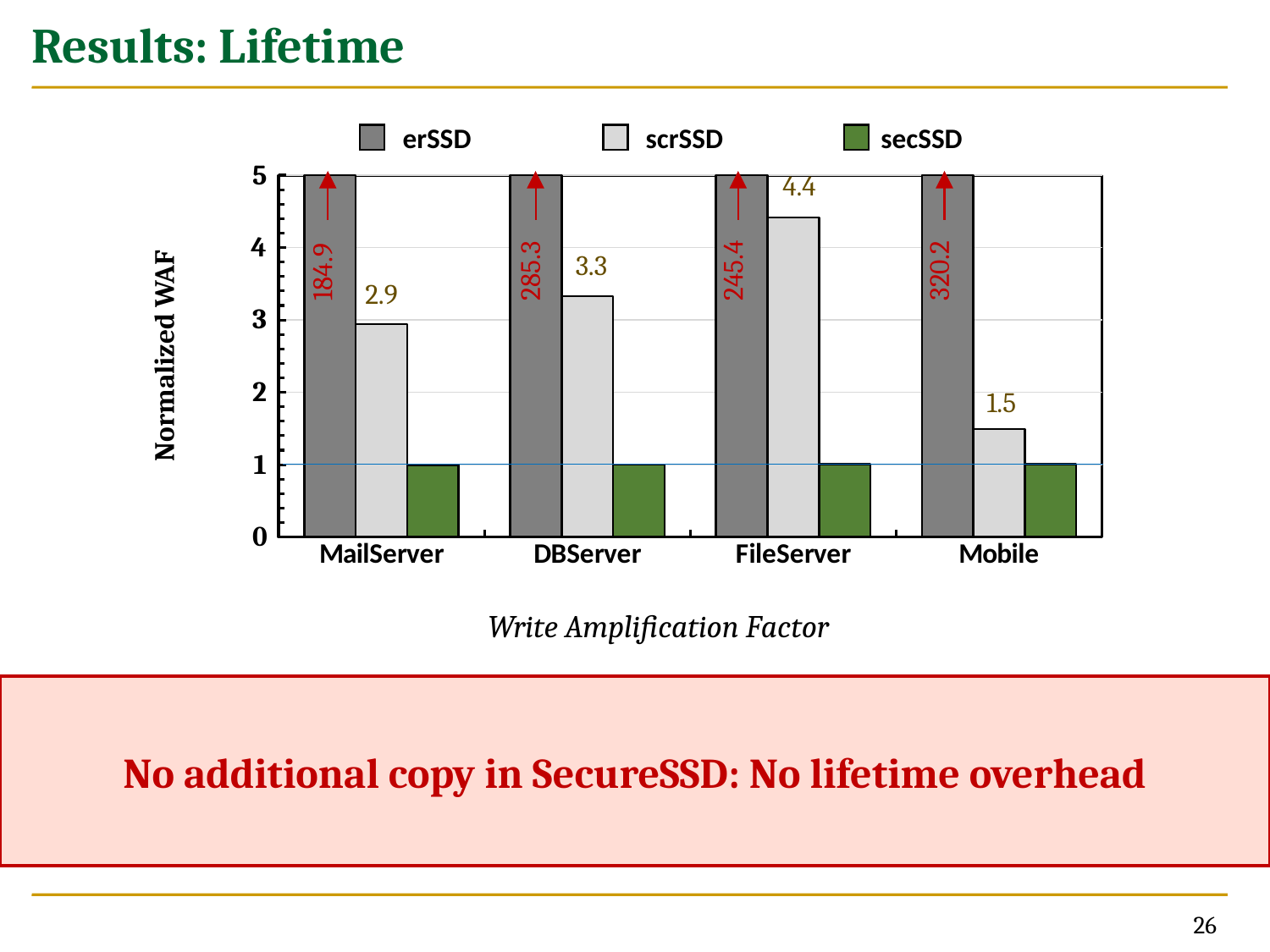
Which workload has the lowest scrSSD value? Mobile Which workload has the highest scrSSD value? FileServer How many series does the legend list? 3 Is the secSSD value for Mobile greater or less than 2? less How many workloads are shown on the x axis? 4 Which workload has the highest erSSD value? Mobile What is the difference between the scrSSD values for FileServer and MailServer? 1.5 What kind of chart is shown on the slide? bar chart What is the erSSD value for Mobile? 320.2 What is the scrSSD value for FileServer? 4.4 What is the erSSD value for MailServer? 184.9 Which is larger, the erSSD value for DBServer or for FileServer? DBServer